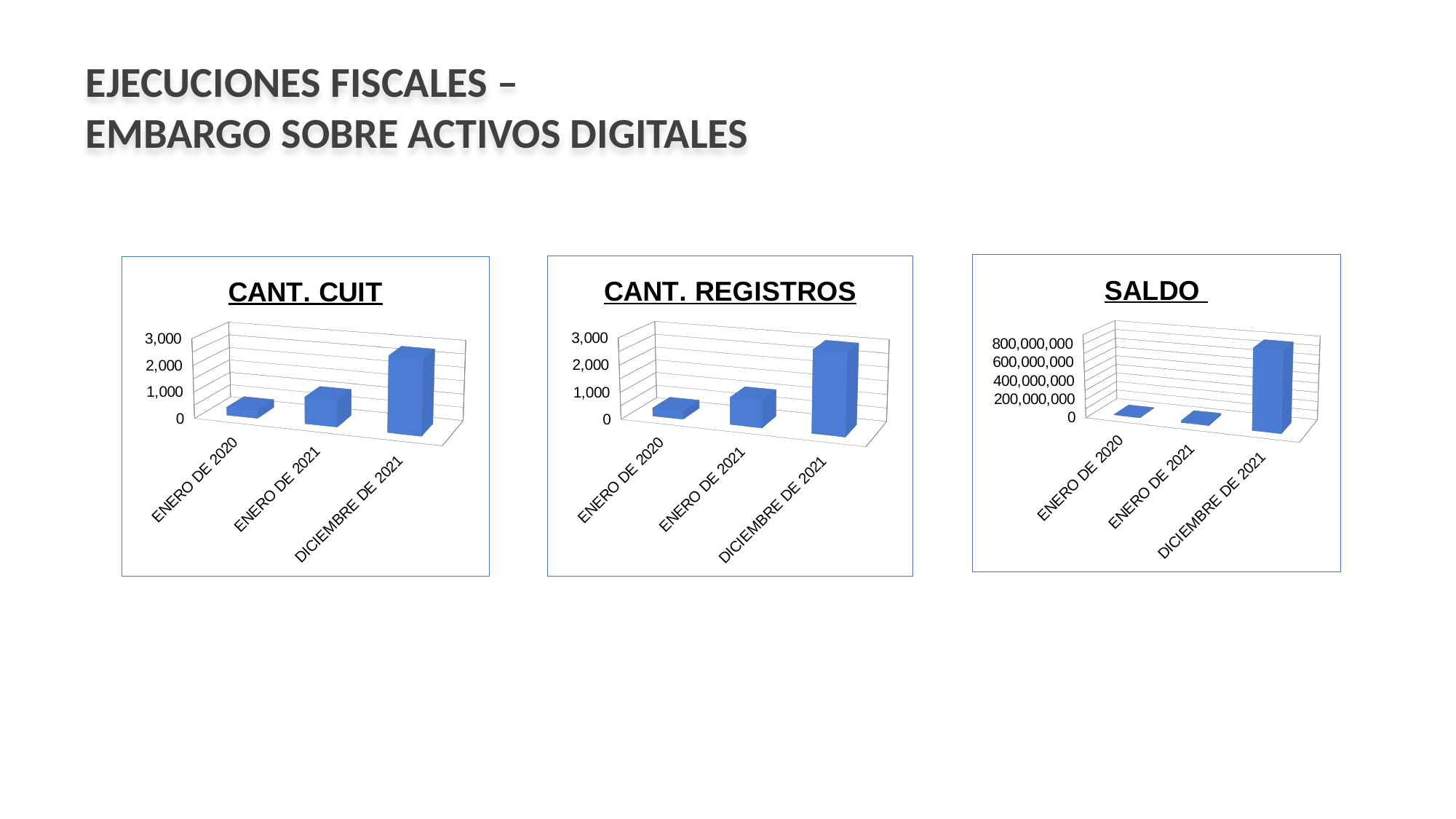
In the CANT. CUIT chart, which category has the highest value? DICIEMBRE DE 2021 In the CANT. REGISTROS chart, is the value for ENERO DE 2020 greater or less than 1,000? less In the CANT. REGISTROS chart, which category has the highest value? DICIEMBRE DE 2021 In the SALDO chart, is the value for DICIEMBRE DE 2021 greater or less than 400,000,000? greater What kind of chart is the CANT. CUIT chart? bar chart What is the title of the rightmost chart on the slide? SALDO In the CANT. CUIT chart, do the values rise or fall from ENERO DE 2020 to DICIEMBRE DE 2021? rise In the CANT. REGISTROS chart, which is larger: ENERO DE 2021 or DICIEMBRE DE 2021? DICIEMBRE DE 2021 How many categories are shown on the x axis of the CANT. REGISTROS chart? 3 In the CANT. CUIT chart, which category has the lowest value? ENERO DE 2020 In the SALDO chart, which category has the highest value? DICIEMBRE DE 2021 In the CANT. CUIT chart, is the value for DICIEMBRE DE 2021 greater or less than 1,000? greater